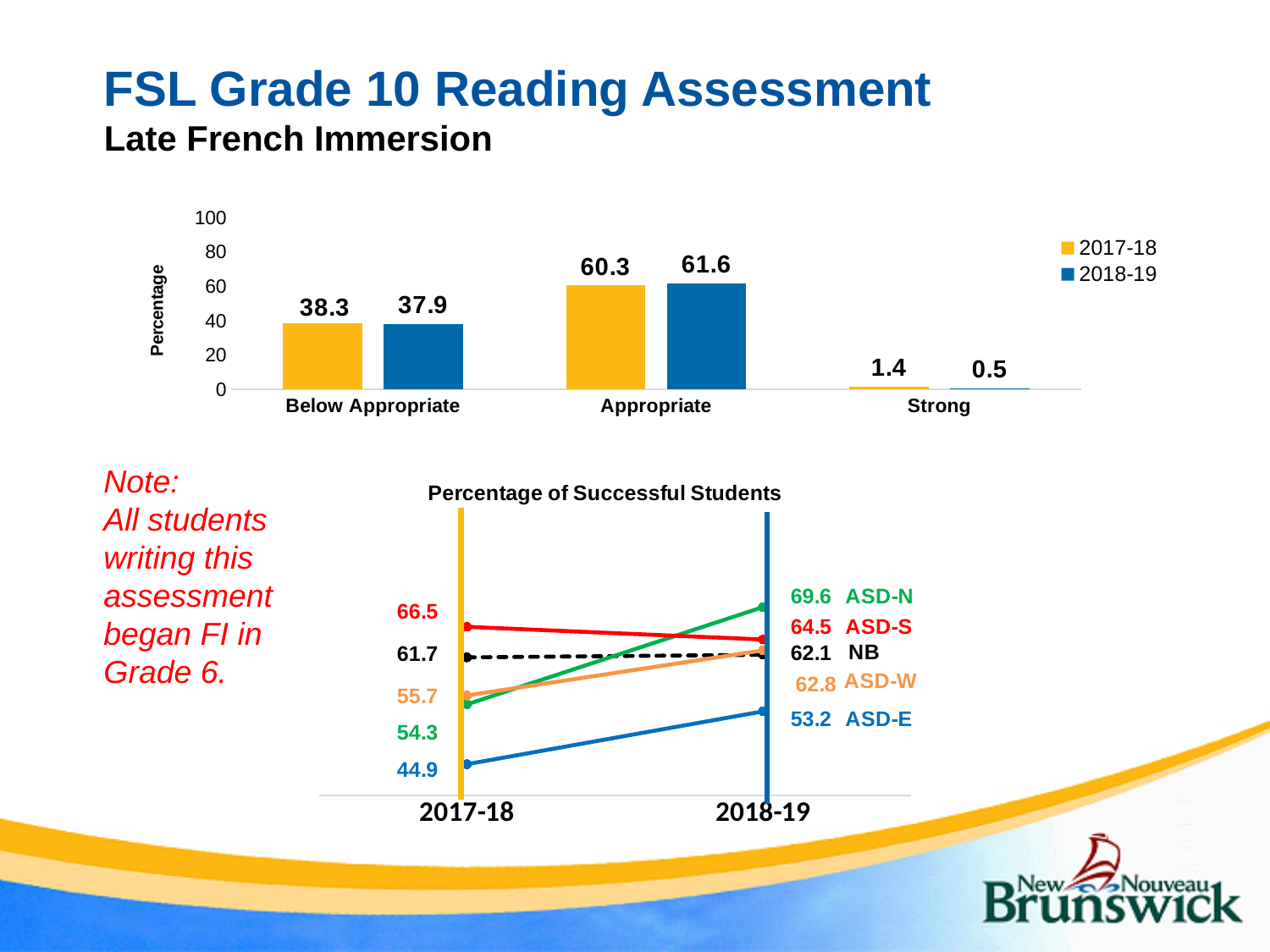
In the top bar chart, how many categories are shown on the x axis? 3 In the top bar chart, which category has the highest 2017-18 value? Appropriate In the Percentage of Successful Students chart, which district has the lowest value in 2018-19? ASD-E In the top bar chart, what is the 2018-19 value for Appropriate? 61.6 What kind of chart is the top chart on the slide? Bar chart In the top bar chart, what is the difference between the 2017-18 and 2018-19 values for Below Appropriate? 0.4 In the top bar chart, what is the 2017-18 value for Below Appropriate? 38.3 In the Percentage of Successful Students chart, what is the 2017-18 value for ASD-E? 44.9 In the top bar chart, what is the 2018-19 value for Strong? 0.5 In the top bar chart, how many series does the legend list? 2 In the Percentage of Successful Students chart, what is the 2018-19 value for ASD-N? 69.6 In the Percentage of Successful Students chart, does the NB value rise or fall from 2017-18 to 2018-19? Rise